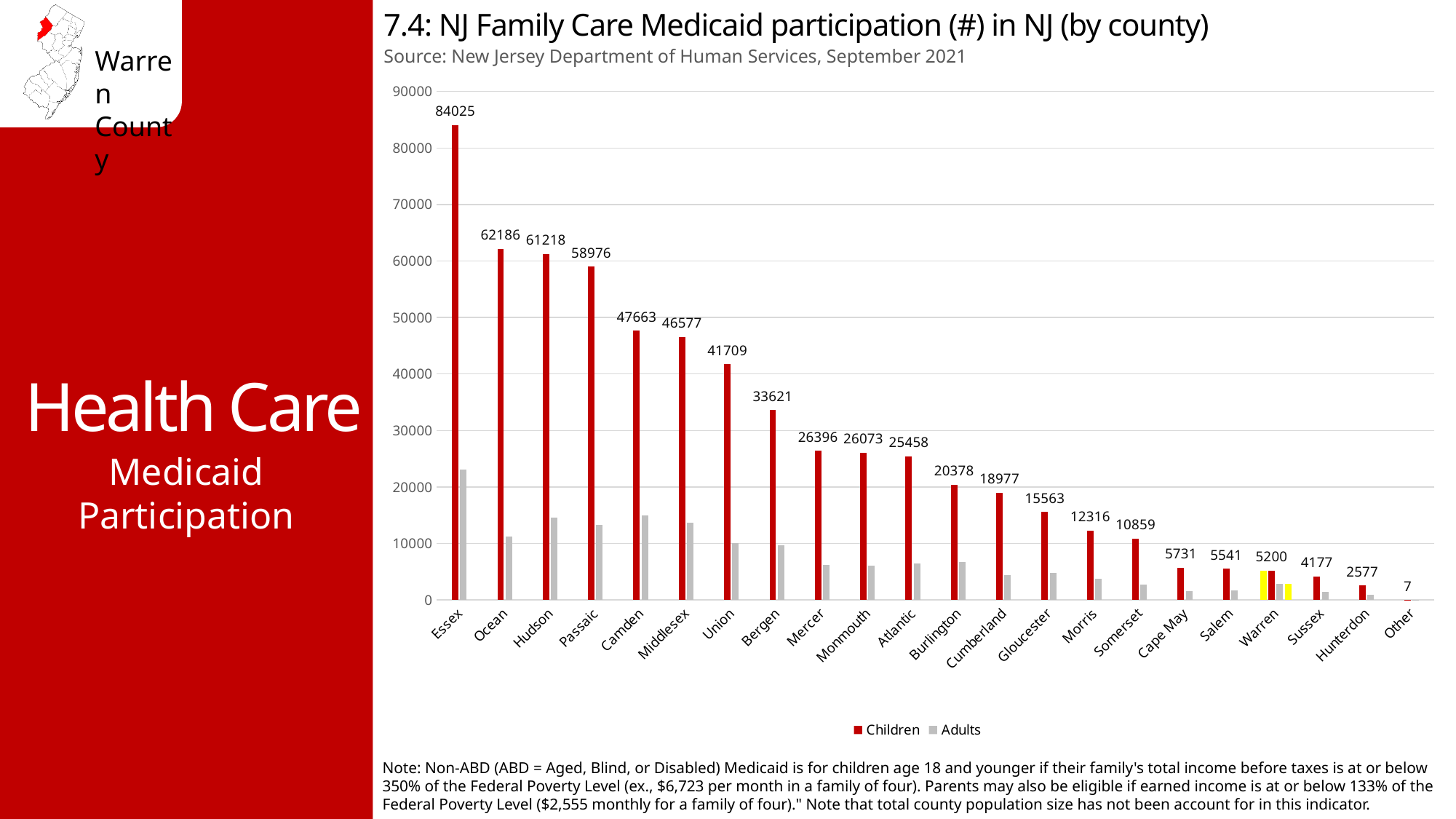
What is the Children value for Warren? 5200 Which has the larger Children value, Camden or Middlesex? Camden Which category has the lowest Children value? Other Do the Children values rise or fall from left to right along the x axis? fall What is the Children value for Essex? 84025 What kind of chart is shown? bar chart What is the difference between the Children values for Ocean and Hudson? 968 How many series does the legend list? 2 How many categories are shown on the x axis? 22 Is the Adults value for Essex greater or less than 20000? greater What is the Children value for Hunterdon? 2577 Which category has the highest Children value? Essex